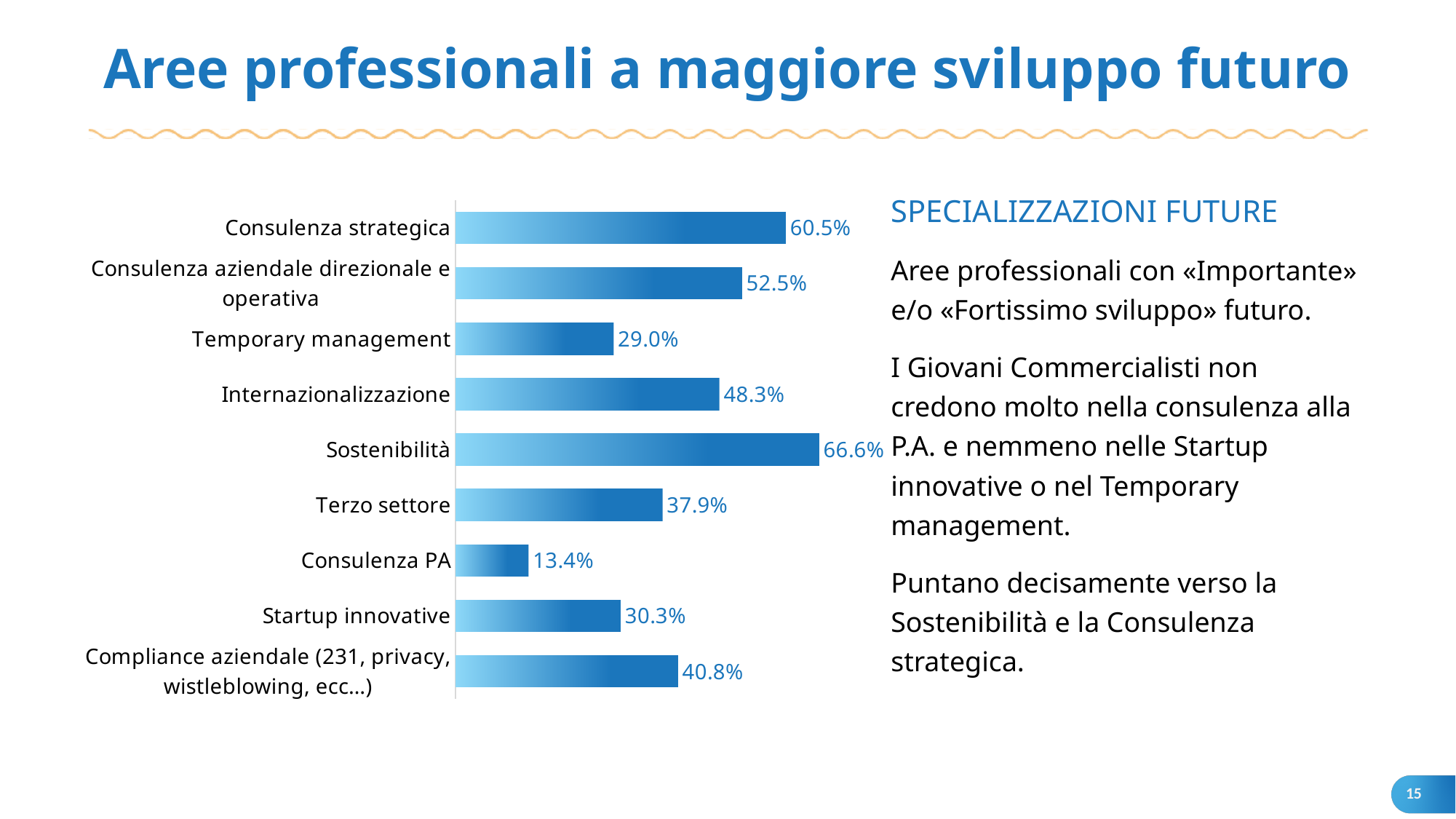
Which is larger, the value for Temporary management or the value for Startup innovative? Startup innovative What is the value for Consulenza strategica? 60.5% What is the difference between the values for Internazionalizzazione and Terzo settore? 10.4% What is the value for Compliance aziendale (231, privacy, wistleblowing, ecc...)? 40.8% Which category has the lowest value? Consulenza PA What kind of chart is shown on the slide? Bar chart What is the difference between the values for Sostenibilità and Consulenza strategica? 6.1% How many categories are shown in the chart? 9 What is the value for Consulenza aziendale direzionale e operativa? 52.5% What is the value for Consulenza PA? 13.4% Which category has the highest value? Sostenibilità What is the value for Sostenibilità? 66.6%